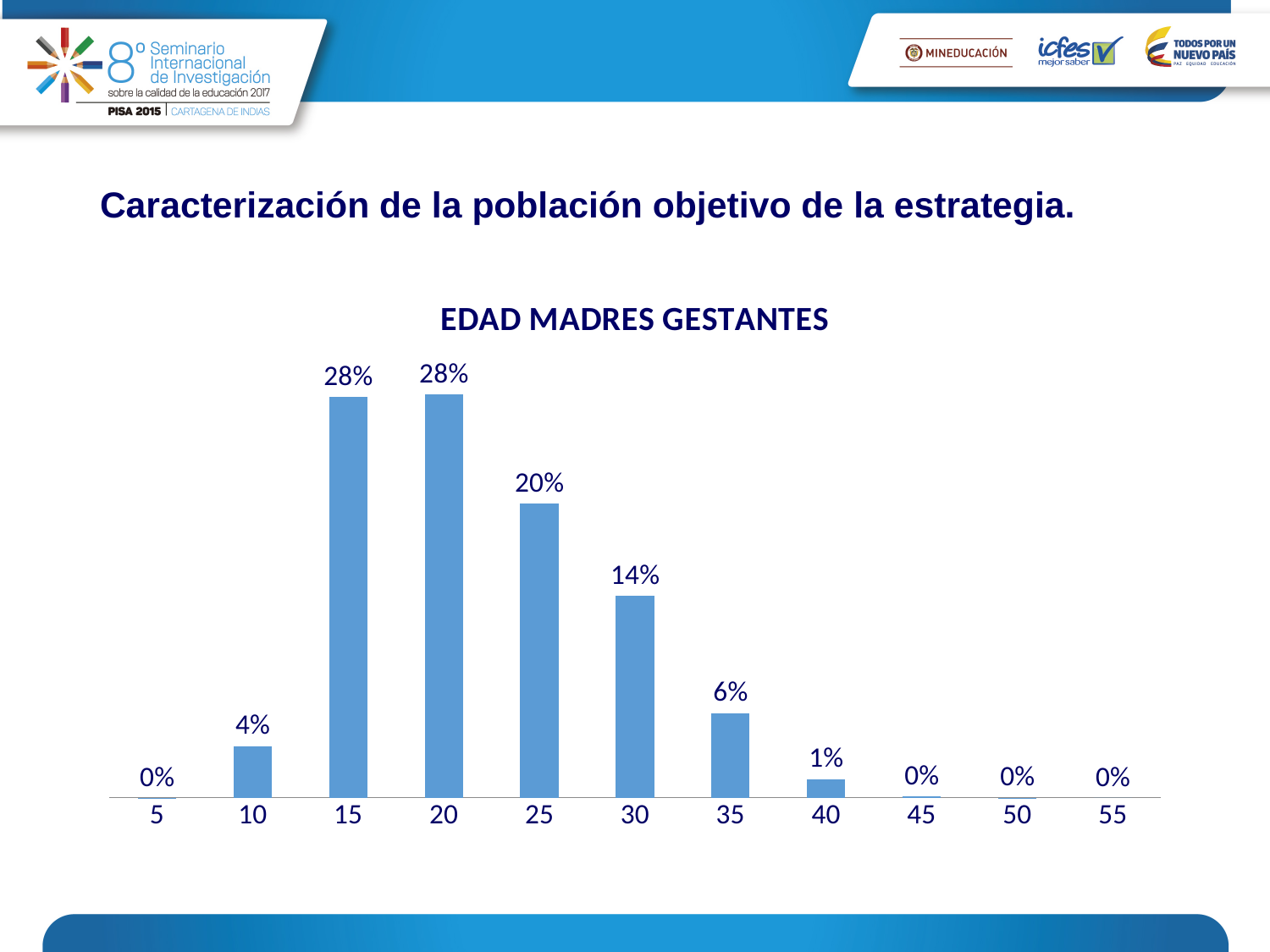
What is the value for age 40 in the EDAD MADRES GESTANTES chart? 1% What is the title of the chart? EDAD MADRES GESTANTES What is the value for age 30 in the EDAD MADRES GESTANTES chart? 14% How many age categories are shown on the x axis? 11 What kind of chart is shown on the slide? Bar chart What is the value for age 10 in the EDAD MADRES GESTANTES chart? 4% Do the values rise or fall along the x axis from age 20 to age 40? Fall Which is larger, the value for age 25 or the value for age 35? 25 What is the value for age 25 in the EDAD MADRES GESTANTES chart? 20% What is the difference between the values for age 15 and age 35? 22% What is the difference between the values for age 25 and age 30? 6% What is the value for age 35 in the EDAD MADRES GESTANTES chart? 6%